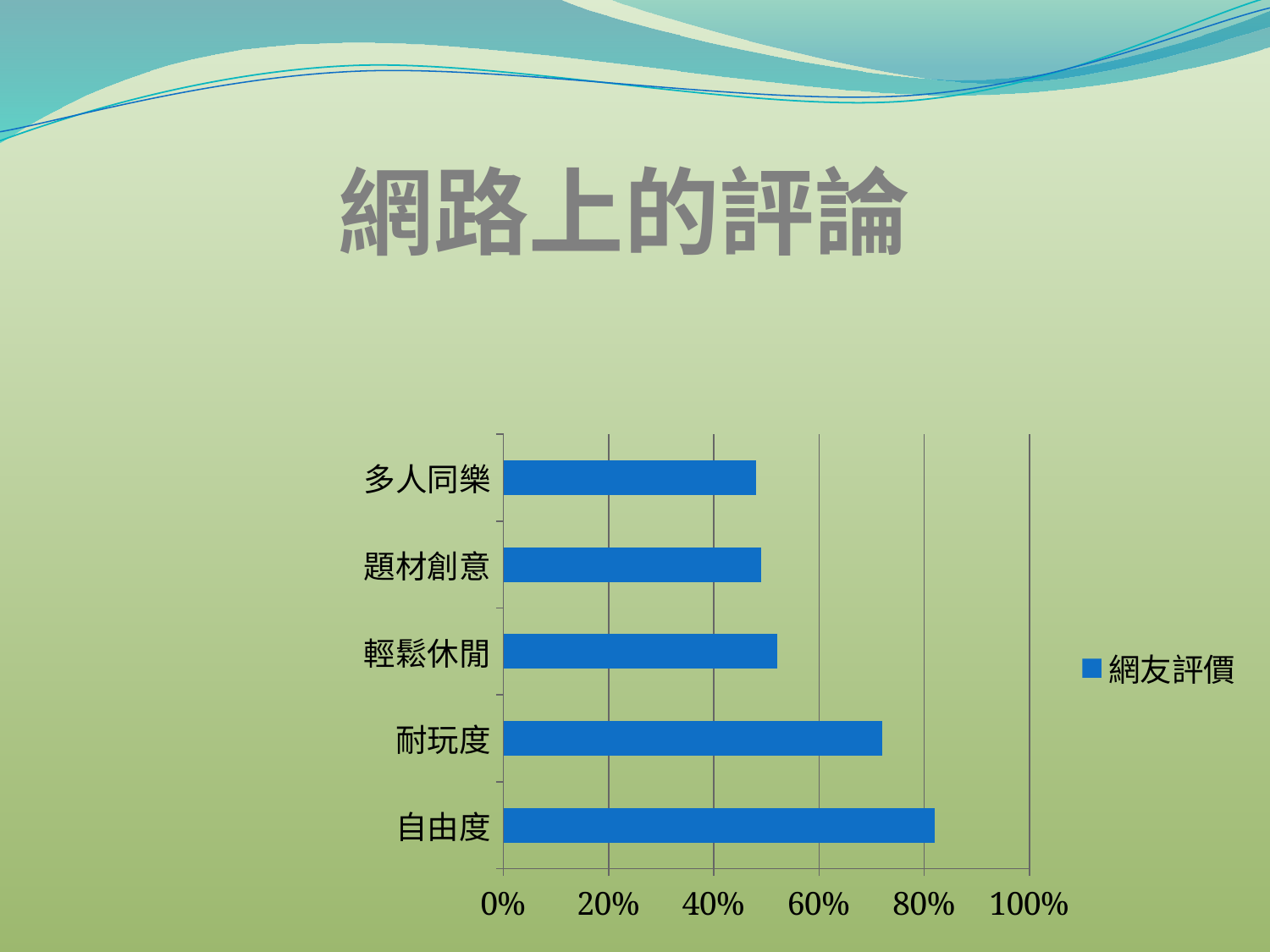
Is the value for 多人同樂 greater or less than 60%? less Which category has the highest value? 自由度 What kind of chart is shown on the slide? bar chart What is the name of the series shown in the legend? 網友評價 How many series does the legend list? 1 What is the title shown above the chart on the slide? 網路上的評論 How many categories are plotted in the chart? 5 Is the value for 自由度 greater or less than 80%? greater Is the value for 耐玩度 greater or less than 60%? greater Which is larger, the value for 耐玩度 or the value for 輕鬆休閒? 耐玩度 Which is larger, the value for 自由度 or the value for 耐玩度? 自由度